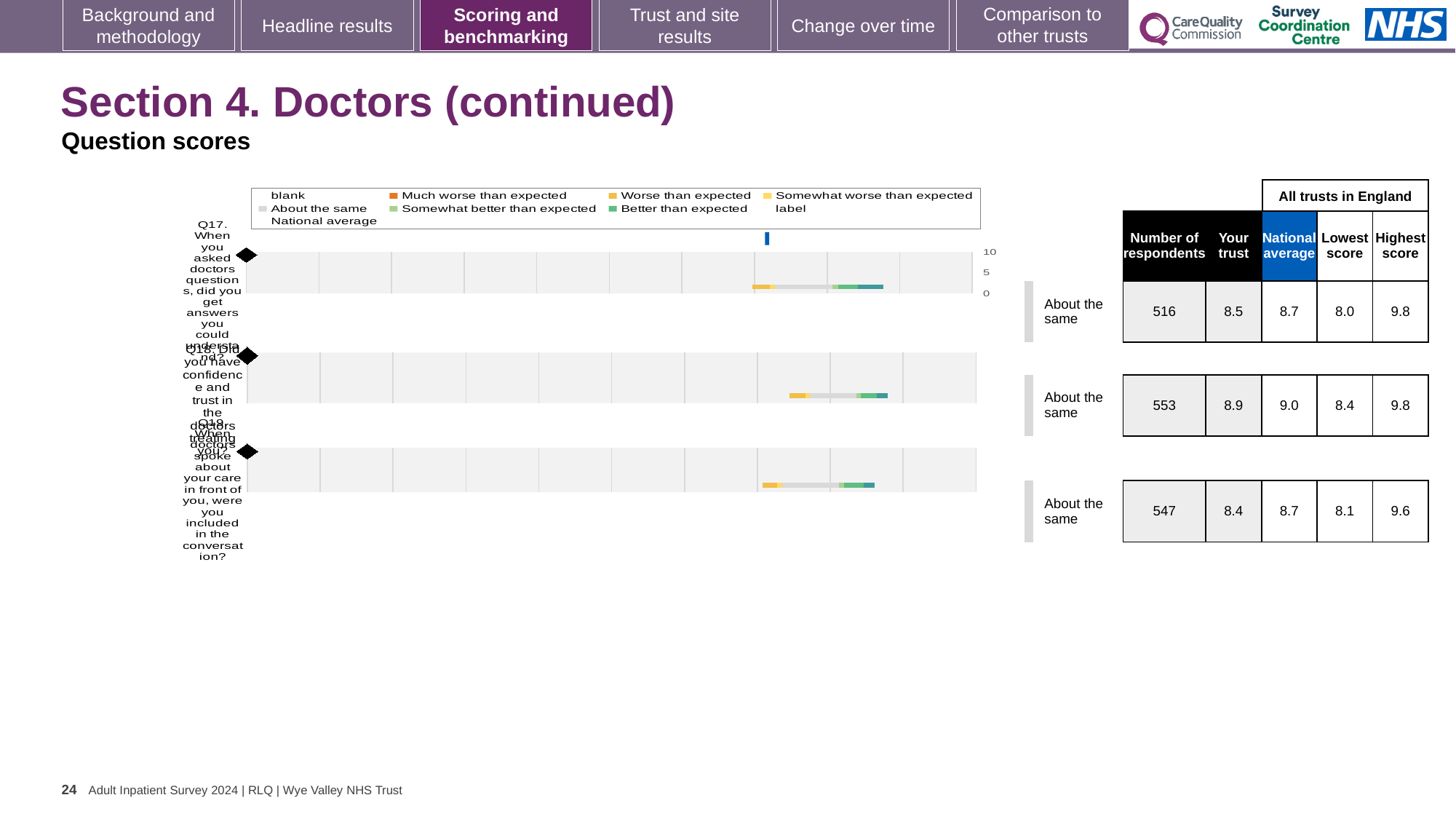
What is the highest score among all trusts in England for Q19? 9.6 What benchmark category is shown for Q17? About the same Which question has the lowest 'Your trust' score? Q19 Which question has the highest 'Your trust' score? Q18 Which legend entry is shown in orange? Much worse than expected How many questions are plotted in the chart? 3 How many respondents answered Q19 (When doctors spoke about your care in front of you, were you included in the conversation)? 547 For Q17, which is larger: the 'Your trust' score or the national average? National average What is the national average score for Q18 (Did you have confidence and trust in the doctors treating you)? 9.0 What kind of chart is used to show the question scores on this slide? bar chart What is the 'Your trust' score for Q17 (When you asked doctors questions, did you get answers you could understand)? 8.5 What is the difference between the national average and the 'Your trust' score for Q18? 0.1